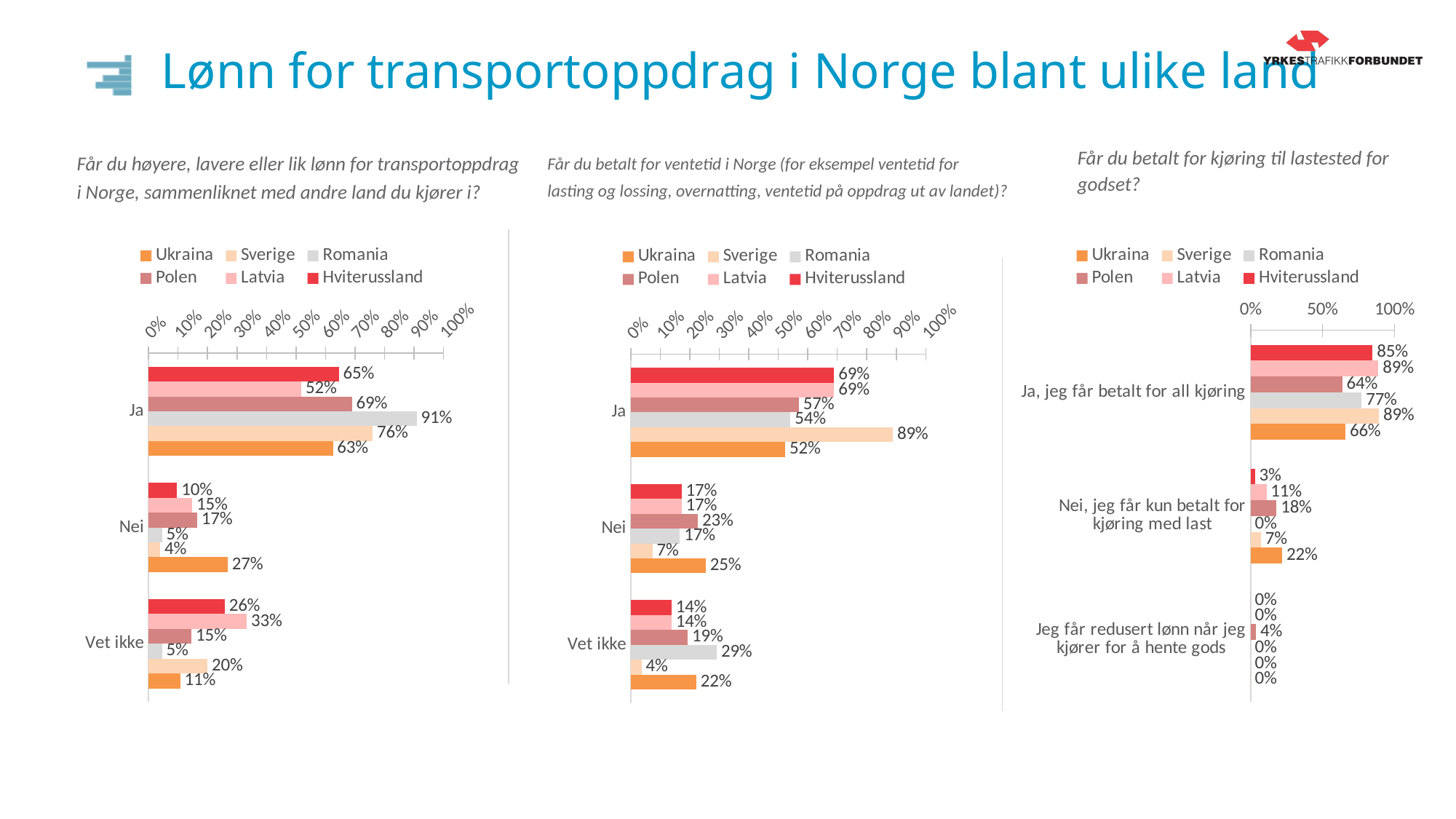
In the right chart, what is the value for Polen in the 'Jeg får redusert lønn når jeg kjører for å hente gods' category? 4% In the right chart, which country has the highest value in the 'Nei, jeg får kun betalt for kjøring med last' category? Ukraina In the left chart, what is the difference between Latvia and Polen in the 'Vet ikke' category? 18% What kind of chart is the right chart? Bar chart How many series does the legend of the left chart list? 6 In the middle chart, which is larger in the 'Vet ikke' category: Romania or Ukraina? Romania In the middle chart, what is the value for Sverige in the 'Ja' category? 89% How many categories are shown on the middle chart? 3 In the left chart, what is the value for Romania in the 'Ja' category? 91% In the middle chart, which country has the lowest value in the 'Nei' category? Sverige In the left chart, which country has the highest value in the 'Nei' category? Ukraina In the right chart, what is the value for Polen in the 'Ja, jeg får betalt for all kjøring' category? 64%